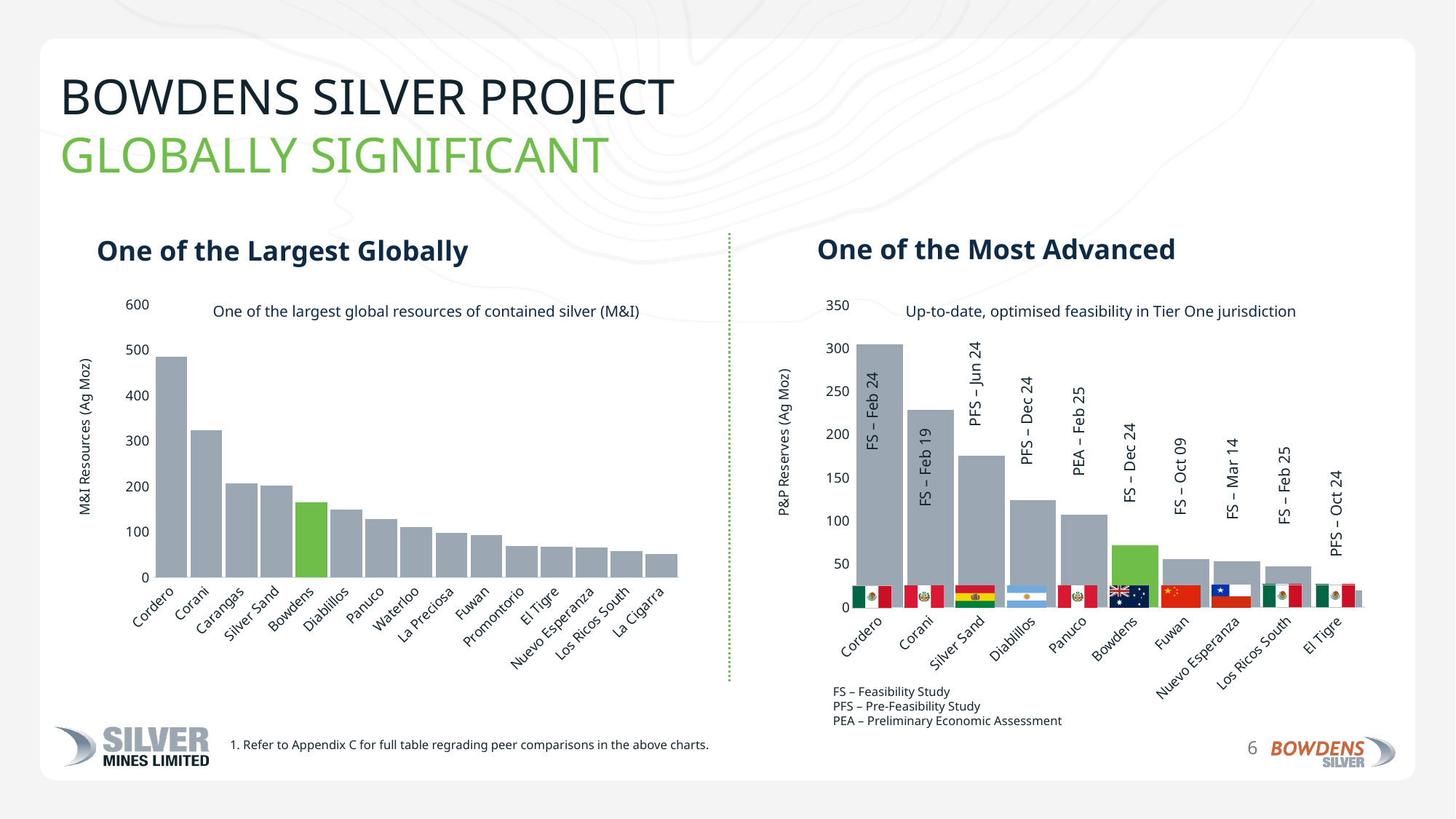
On the left chart (One of the largest global resources of contained silver), which project has the highest M&I resources? Cordero On the left chart (One of the largest global resources of contained silver), is the value for Bowdens greater or less than 200? less On the right chart (Up-to-date, optimised feasibility in Tier One jurisdiction), is the value for Bowdens greater or less than 100? less On the left chart (One of the largest global resources of contained silver), which is larger, Corani or Carangas? Corani On the right chart (Up-to-date, optimised feasibility in Tier One jurisdiction), how many projects are plotted? 10 On the left chart (One of the largest global resources of contained silver), what kind of chart is shown? bar chart On the left chart (One of the largest global resources of contained silver), do the values rise or fall from left to right? fall On the right chart (Up-to-date, optimised feasibility in Tier One jurisdiction), what study label is shown above the Bowdens bar? FS – Dec 24 On the left chart (One of the largest global resources of contained silver), how many projects are plotted? 15 On the left chart (One of the largest global resources of contained silver), which project has the lowest M&I resources? La Cigarra On the right chart (Up-to-date, optimised feasibility in Tier One jurisdiction), which project has the highest P&P reserves? Cordero On the left chart (One of the largest global resources of contained silver), is the value for Cordero greater or less than 400? greater